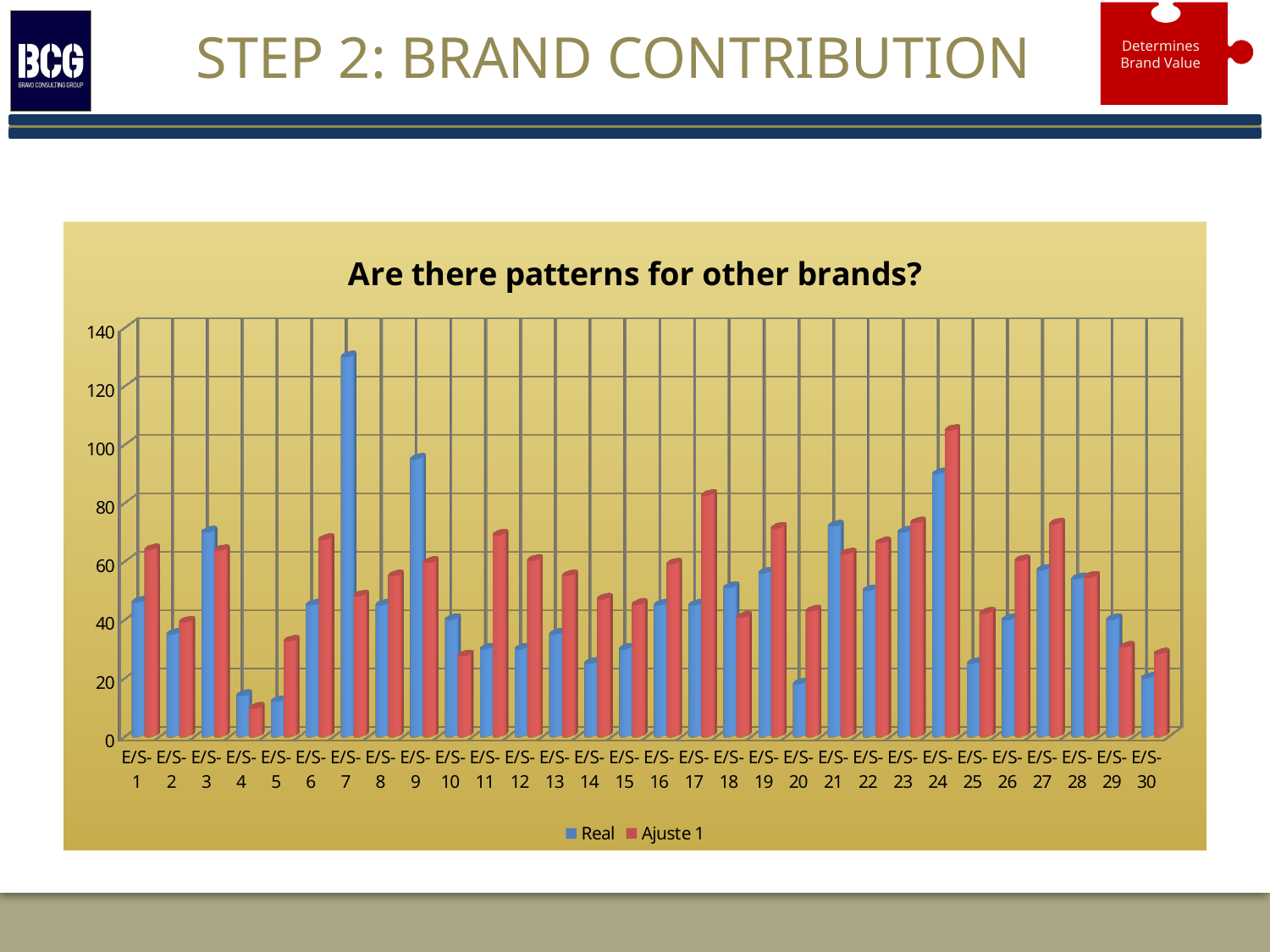
What is the title of the chart? Are there patterns for other brands? For E/S-17, which series has the larger value, Real or Ajuste 1? Ajuste 1 How many categories are shown on the x axis? 30 Which category has the highest value for the Ajuste 1 series? E/S-24 Is the Real value for E/S-4 greater or less than 20? less How many series does the legend list? 2 For E/S-7, which series has the larger value, Real or Ajuste 1? Real What kind of chart is shown on the slide? Bar chart Which category has the highest value for the Real series? E/S-7 Is the Real value for E/S-7 greater or less than 120? greater Is the Ajuste 1 value for E/S-24 greater or less than 100? greater What are the names of the two series in the legend? Real and Ajuste 1